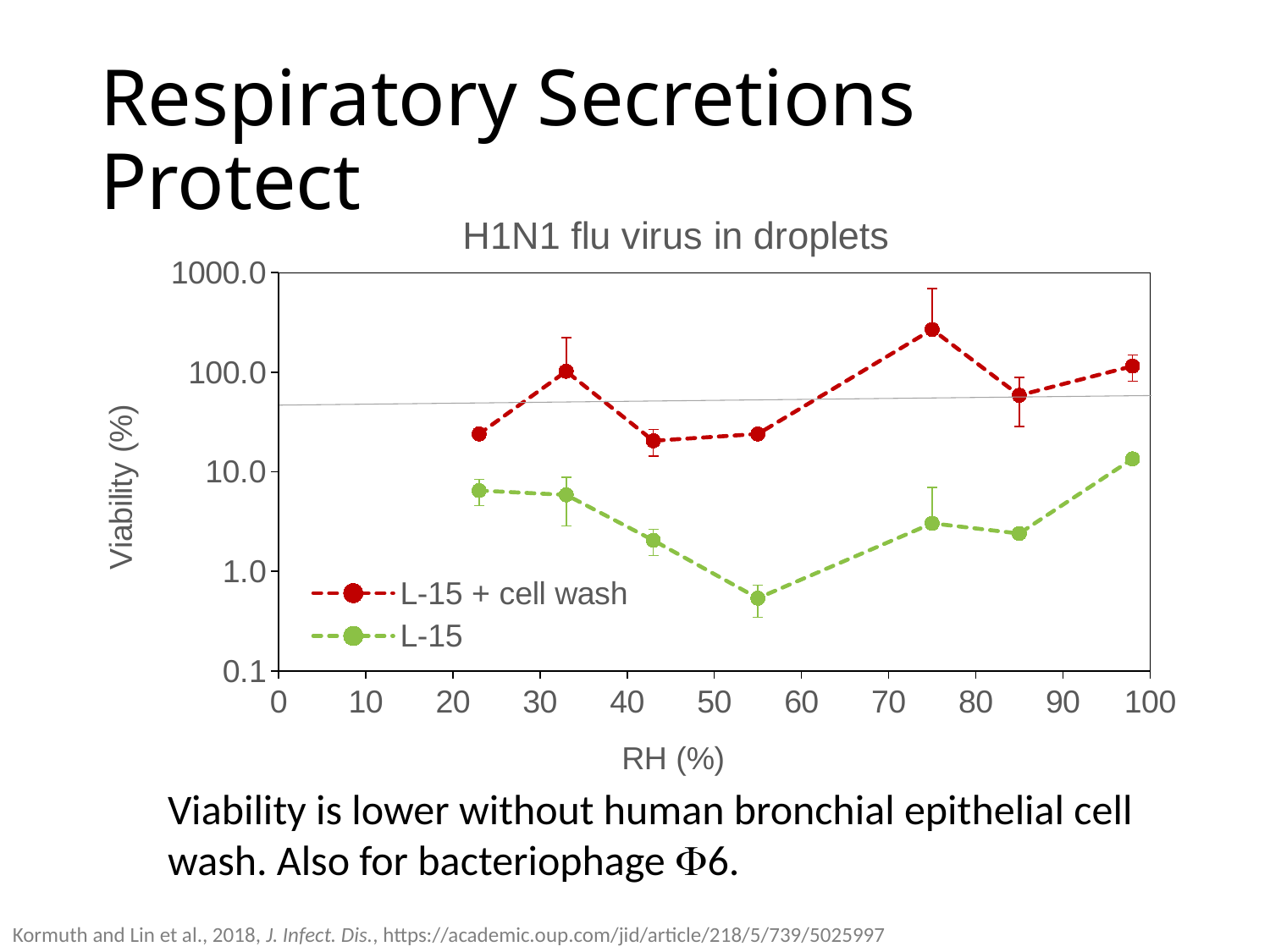
Is the viability for L-15 at about 98% RH greater or less than 10.0? greater How many data points are plotted for the L-15 series? 7 At about 55% RH, which series has the higher viability, L-15 + cell wash or L-15? L-15 + cell wash What is the title of the chart? H1N1 flu virus in droplets Is the viability for L-15 + cell wash at about 43% RH greater or less than 100.0? less How many series does the legend list? 2 What kind of chart is shown on the slide? line chart Is the viability for L-15 at about 55% RH greater or less than 1.0? less What is the label of the y axis? Viability (%)